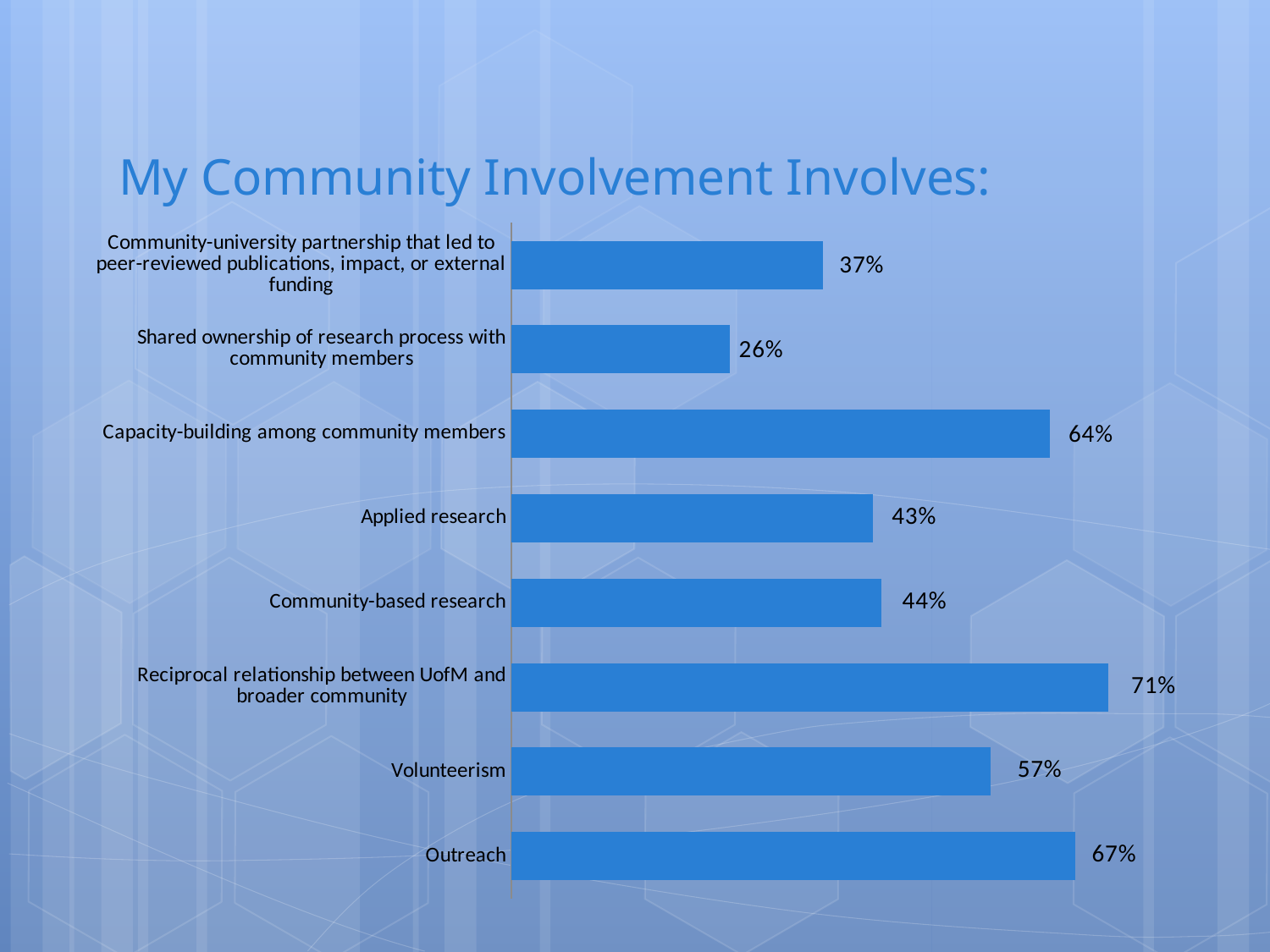
What is the value for Shared ownership of research process with community members? 26% Which is larger, the value for Capacity-building among community members or the value for Volunteerism? Capacity-building among community members What is the difference between the values for Outreach and Volunteerism? 10% What is the title of the slide? My Community Involvement Involves: Which category has the highest value? Reciprocal relationship between UofM and broader community What is the value for Volunteerism? 57% Which category has the lowest value? Shared ownership of research process with community members What is the value for Capacity-building among community members? 64% What kind of chart is shown on the slide? Bar chart What is the difference between the values for Community-based research and Applied research? 1% What is the value for Outreach? 67% How many categories are shown in the chart? 8